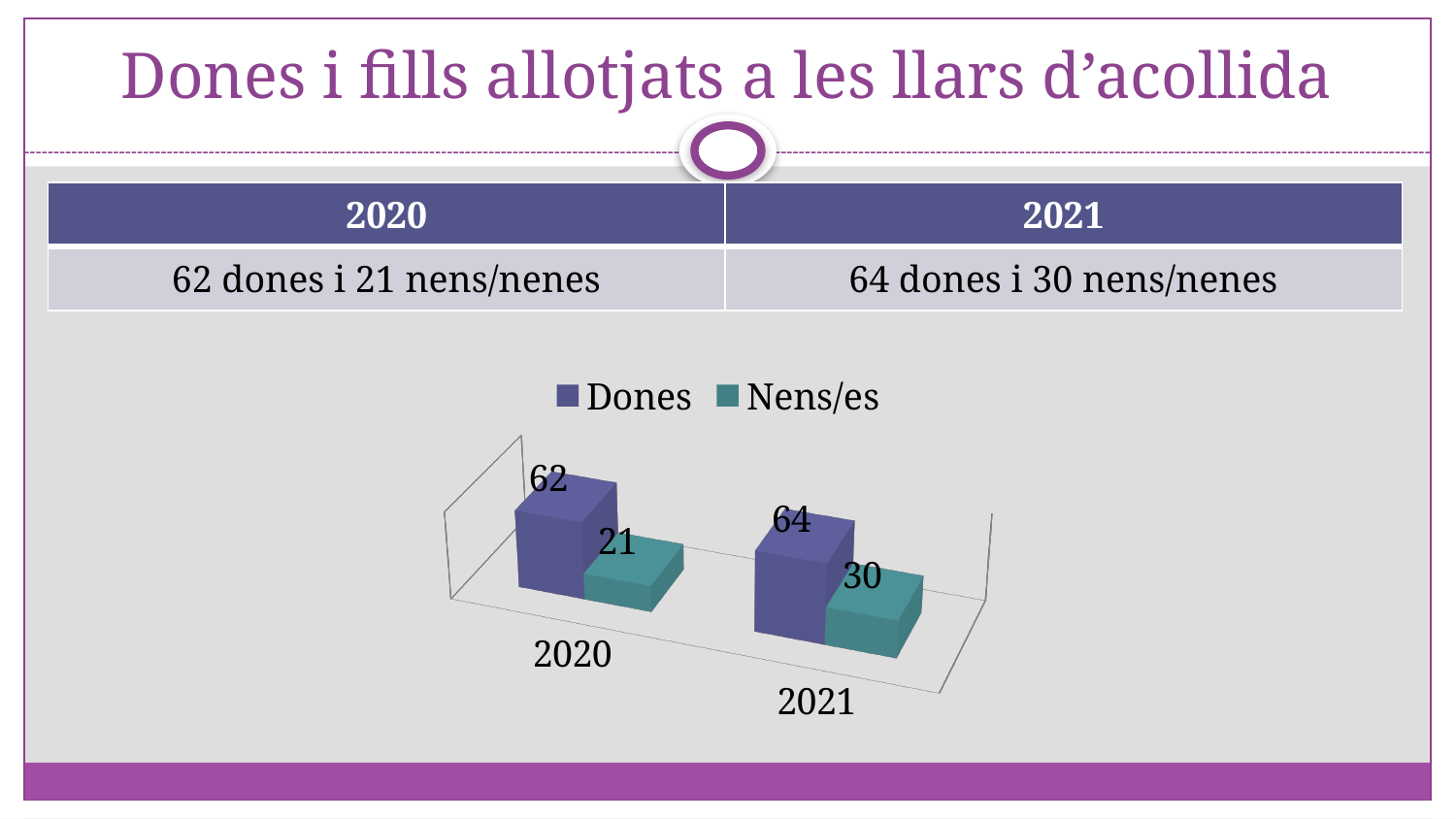
What kind of chart is shown on the slide? Bar chart Which year has the higher value for Nens/es? 2021 Which is larger in 2021, Dones or Nens/es? Dones Does the Dones value rise or fall from 2020 to 2021? Rise What is the value for Dones in 2021? 64 What is the value for Dones in 2020? 62 By how much did the Nens/es value increase from 2020 to 2021? 9 How many years are shown on the x axis of the chart? 2 What is the value for Nens/es in 2021? 30 How many series does the legend list? 2 What is the difference between Dones and Nens/es in 2020? 41 What is the value for Nens/es in 2020? 21